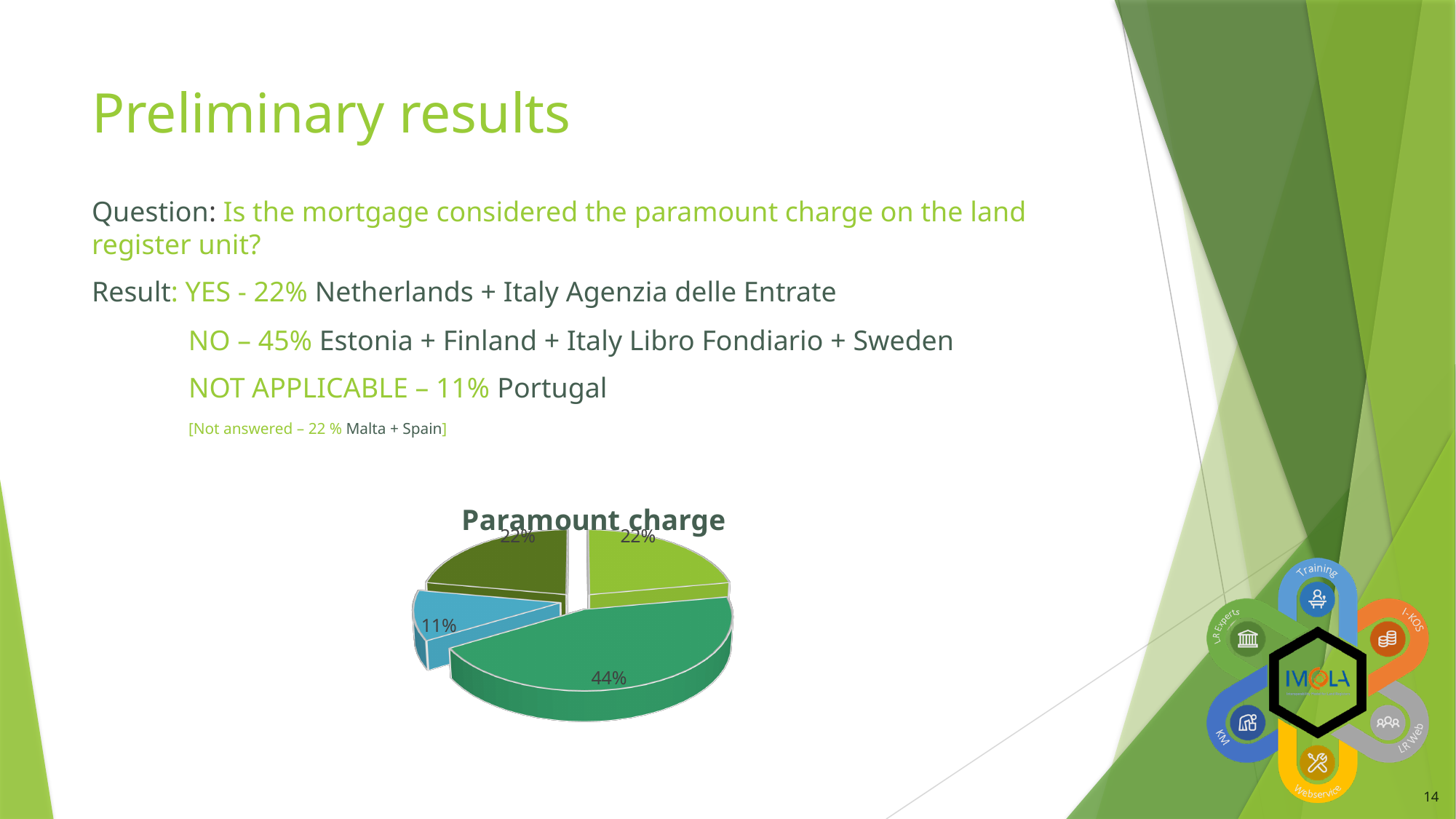
In the "Paramount charge" pie chart, which is larger: the blue slice or the large teal-green slice? the large teal-green slice What kind of chart is shown under the title "Paramount charge"? pie chart What is the value of the smallest slice in the "Paramount charge" pie chart? 11% How many slices does the "Paramount charge" pie chart have? 4 What percentage is shown on the dark olive green slice at the top left of the "Paramount charge" pie chart? 22% How many slices in the "Paramount charge" pie chart are labelled 22%? 2 What percentage is shown on the light green slice at the top right of the "Paramount charge" pie chart? 22% In the "Paramount charge" pie chart, what is the difference between the largest slice (44%) and the smallest slice (11%)? 33 percentage points What is the title of the chart on the slide? Paramount charge What percentage is shown on the blue slice of the "Paramount charge" pie chart? 11% What is the value of the largest slice in the "Paramount charge" pie chart? 44% Does the "Paramount charge" pie chart include a legend? No